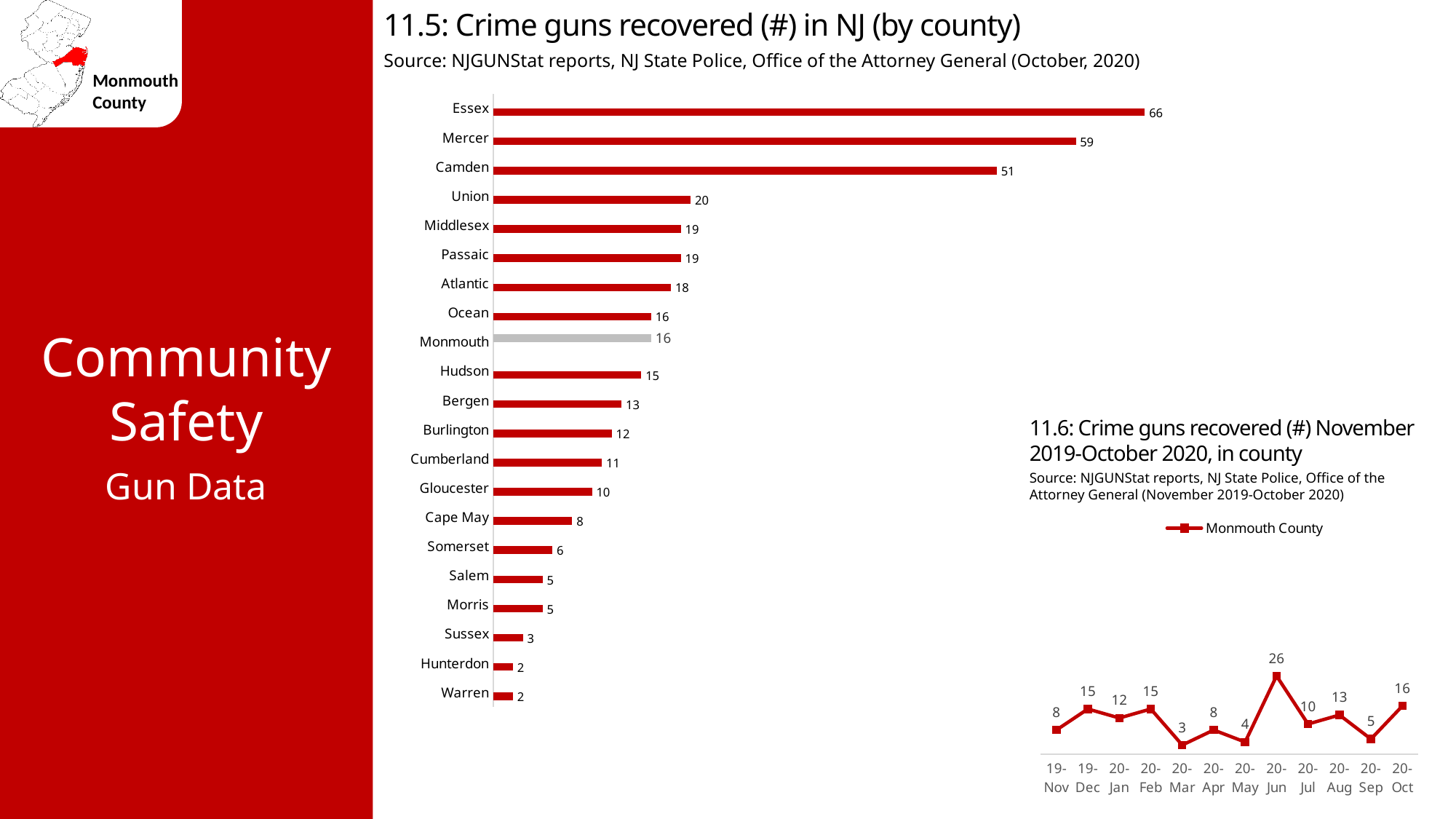
In the chart '11.6: Crime guns recovered (#) November 2019-October 2020, in county', what is the difference between 20-Jun and 20-Jul? 16 In the chart '11.5: Crime guns recovered (#) in NJ (by county)', how many counties are shown? 21 In the chart '11.5: Crime guns recovered (#) in NJ (by county)', how many crime guns were recovered in Essex? 66 In the chart '11.5: Crime guns recovered (#) in NJ (by county)', which is larger, Union or Hudson? Union In the chart '11.5: Crime guns recovered (#) in NJ (by county)', which bar is shown in grey instead of red? Monmouth In the chart '11.5: Crime guns recovered (#) in NJ (by county)', what is the value for Monmouth? 16 In the chart '11.5: Crime guns recovered (#) in NJ (by county)', which county has the highest number of crime guns recovered? Essex In the chart '11.5: Crime guns recovered (#) in NJ (by county)', what is the difference between Essex and Mercer? 7 What type of chart is '11.5: Crime guns recovered (#) in NJ (by county)'? Bar chart In the chart '11.6: Crime guns recovered (#) November 2019-October 2020, in county', what is the value for 20-Jun? 26 In the chart '11.6: Crime guns recovered (#) November 2019-October 2020, in county', which month has the lowest value? 20-Mar In the chart '11.6: Crime guns recovered (#) November 2019-October 2020, in county', how many series does the legend list? 1